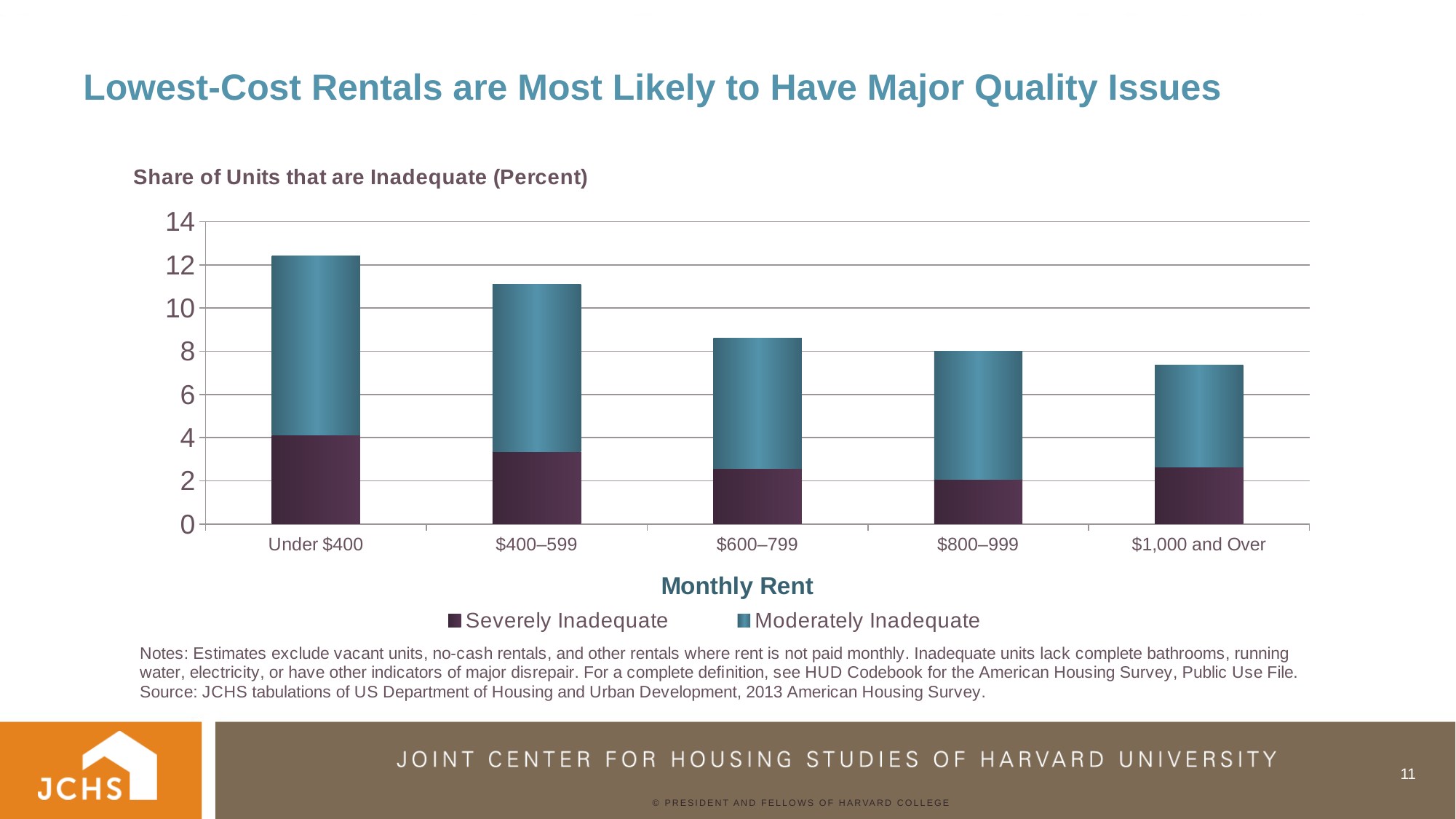
Which has a larger total share of inadequate units, Under $400 or $400–599? Under $400 Is the total share of inadequate units for $1,000 and Over greater or less than 8? less How many monthly rent categories are shown on the x axis? 5 Is the total share of inadequate units for Under $400 greater or less than 10? greater What kind of chart is shown on the slide? Stacked bar chart How many series does the legend list? 2 Which monthly rent category has the lowest total share of inadequate units? $1,000 and Over Which monthly rent category has the highest total share of inadequate units? Under $400 Which has a larger Severely Inadequate share, Under $400 or $1,000 and Over? Under $400 Does the total share of inadequate units rise or fall as monthly rent increases along the x axis? Fall What is the label of the x axis? Monthly Rent Is the Severely Inadequate share for Under $400 greater or less than 2? greater